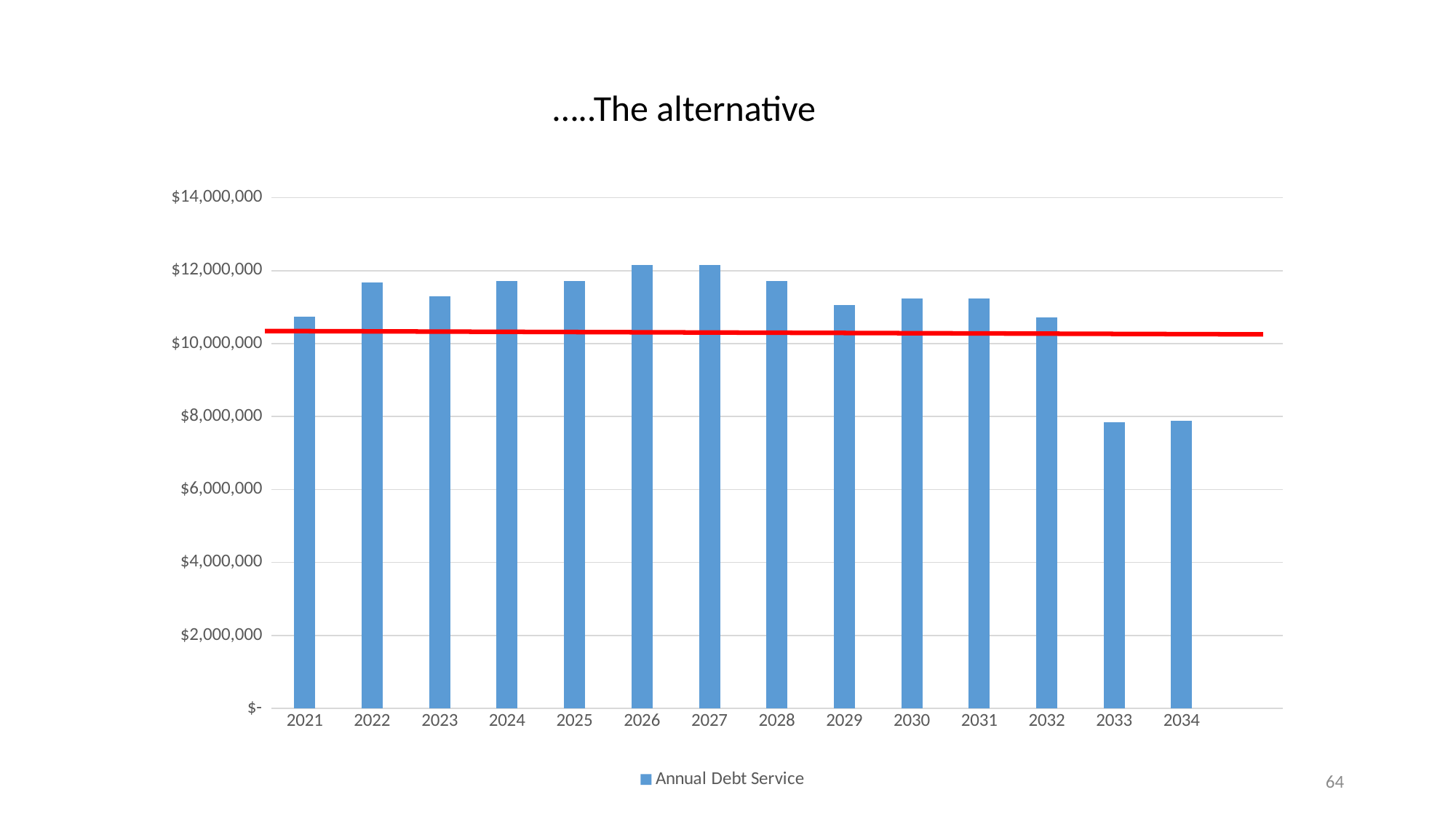
Is the value for 2033 greater or less than $8,000,000? less Do the values rise or fall from 2032 to 2033? fall Is the value for 2021 greater or less than $10,000,000? greater How many series does the chart legend list? 1 How many years are shown on the x axis of the chart? 14 Which year has the larger value, 2027 or 2032? 2027 Is the value for 2023 greater or less than $12,000,000? less Which year has the larger value, 2022 or 2033? 2022 What is the name of the series shown in the chart legend? Annual Debt Service What is the title of the slide containing the chart? …..The alternative What kind of chart is shown on the slide? bar chart